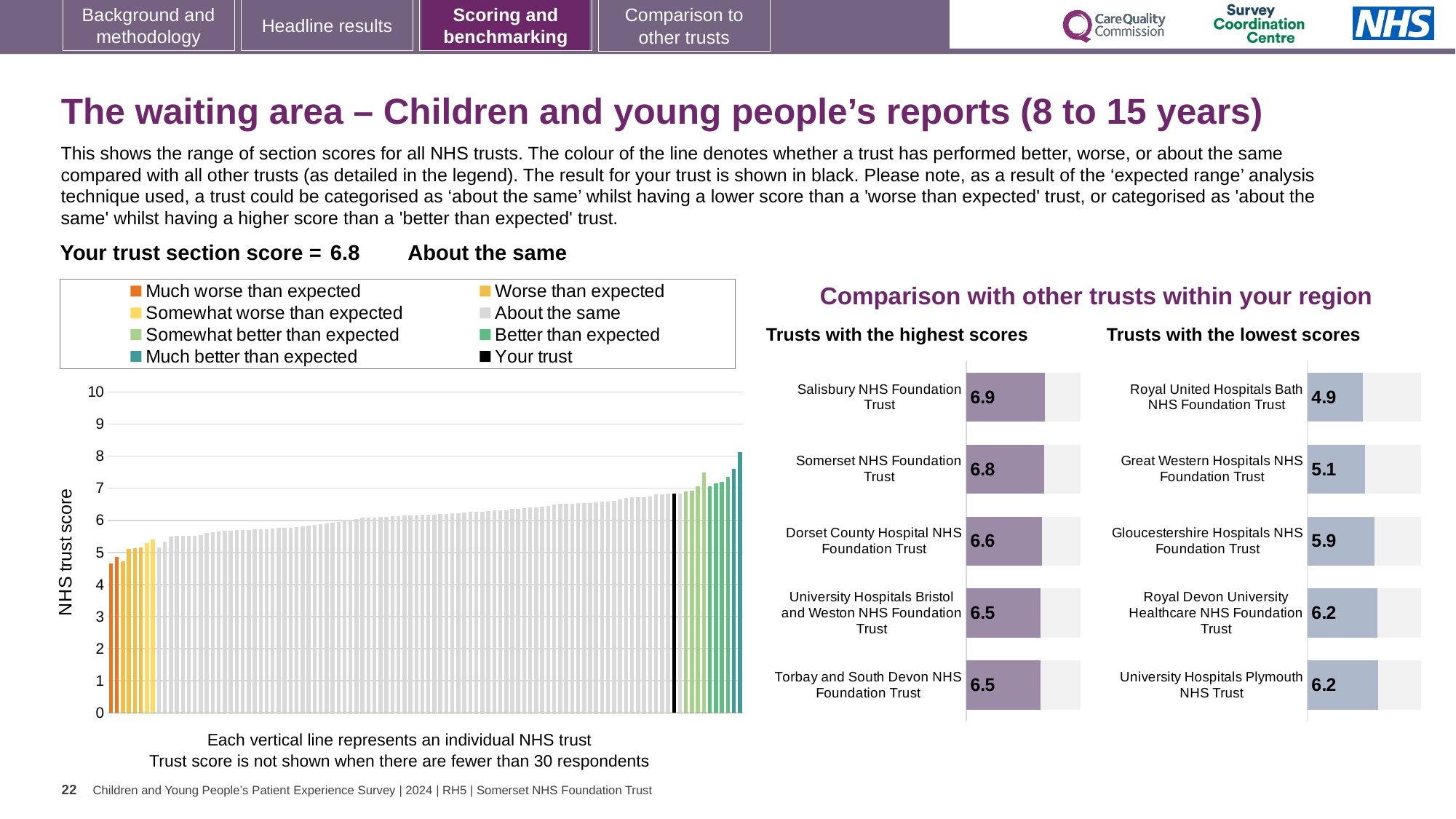
How many entries does the legend above the large 'NHS trust score' chart list? 8 How many trusts are listed in the 'Trusts with the lowest scores' chart? 5 In the 'Trusts with the highest scores' chart, what is the difference between the scores of Salisbury NHS Foundation Trust and Torbay and South Devon NHS Foundation Trust? 0.4 In the 'Trusts with the highest scores' chart, which has the larger score: Somerset NHS Foundation Trust or Dorset County Hospital NHS Foundation Trust? Somerset NHS Foundation Trust In the large 'NHS trust score' chart on the left, do the bar values rise or fall from left to right? rise In the 'Trusts with the highest scores' chart, what is the score for Salisbury NHS Foundation Trust? 6.9 In the 'Trusts with the lowest scores' chart, which trust has the lowest score? Royal United Hospitals Bath NHS Foundation Trust In the large 'NHS trust score' chart on the left, is the value of the lowest bar greater or less than 5? less In the 'Trusts with the highest scores' chart, which trust has the highest score? Salisbury NHS Foundation Trust In the 'Trusts with the lowest scores' chart, what is the difference between the scores of Gloucestershire Hospitals NHS Foundation Trust and Royal United Hospitals Bath NHS Foundation Trust? 1.0 In the 'Trusts with the lowest scores' chart, what is the score for Great Western Hospitals NHS Foundation Trust? 5.1 What kind of chart is the large 'NHS trust score' chart on the left? bar chart